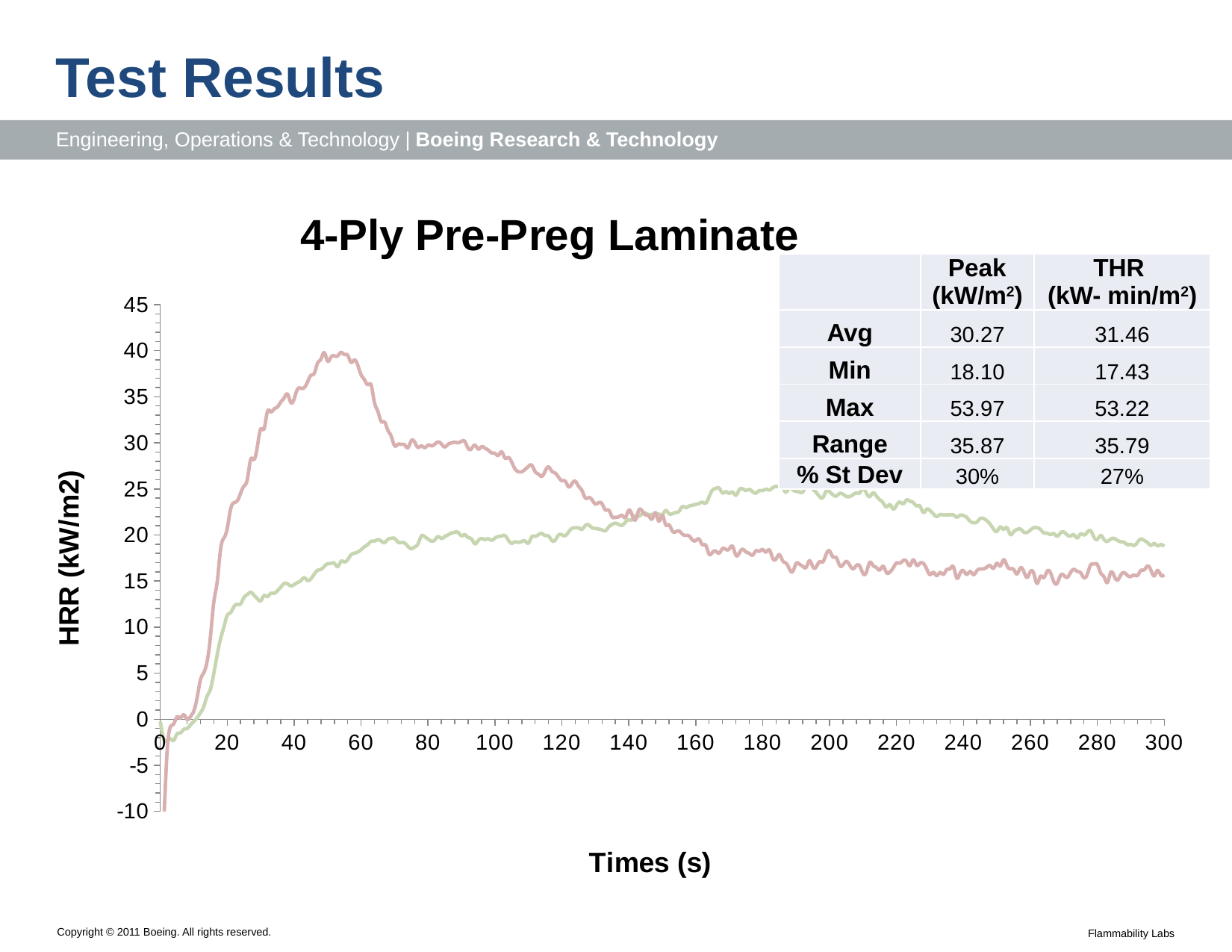
What kind of chart is shown on the slide? line chart How many lines are plotted on the chart? 2 At 50 s, which line has the higher value, the red line or the green line? the red line What is the title of the chart? 4-Ply Pre-Preg Laminate Does the red line rise or fall between 60 s and 300 s? fall At 250 s, which line has the higher value, the red line or the green line? the green line Is the value of the red line at 200 s greater or less than 20? less What is the label of the y axis of the chart? HRR (kW/m2) Is the value of the red line at 300 s greater or less than 20? less Is the value of the green line at 300 s greater or less than 25? less